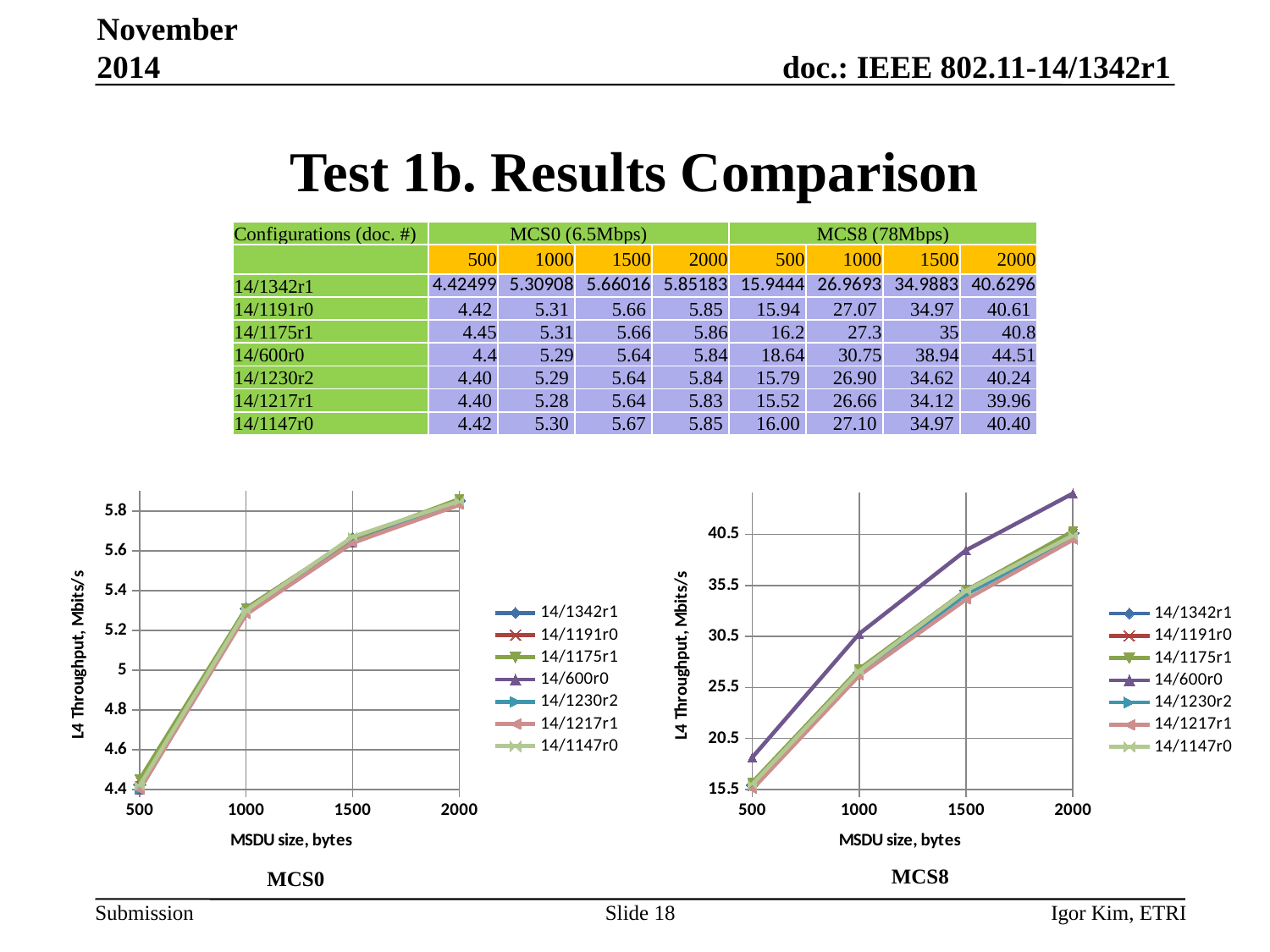
In the MCS8 chart, is the value for 14/600r0 at 500 bytes greater or less than 20.5? less In the MCS0 chart, is the value for 14/1342r1 at 1000 bytes greater or less than 5.2? greater What kind of chart is the MCS0 chart on the left? line chart In the MCS8 chart, which is larger at 1000 bytes: 14/600r0 or 14/1342r1? 14/600r0 In the MCS0 chart, do the throughput values rise or fall as MSDU size increases from 500 to 2000 bytes? rise In the MCS0 chart, is the value for 14/1175r1 at 500 bytes greater or less than 4.6? less According to the table, what is the MCS8 throughput for 14/600r0 at an MSDU size of 2000 bytes, as plotted in the MCS8 chart? 44.51 How many series does the legend of the MCS8 chart list? 7 In the MCS8 chart, which series has the highest throughput at an MSDU size of 2000 bytes? 14/600r0 How many MSDU size points are plotted along the x axis of the MCS0 chart? 4 What is the y-axis label of the MCS8 chart? L4 Throughput, Mbits/s